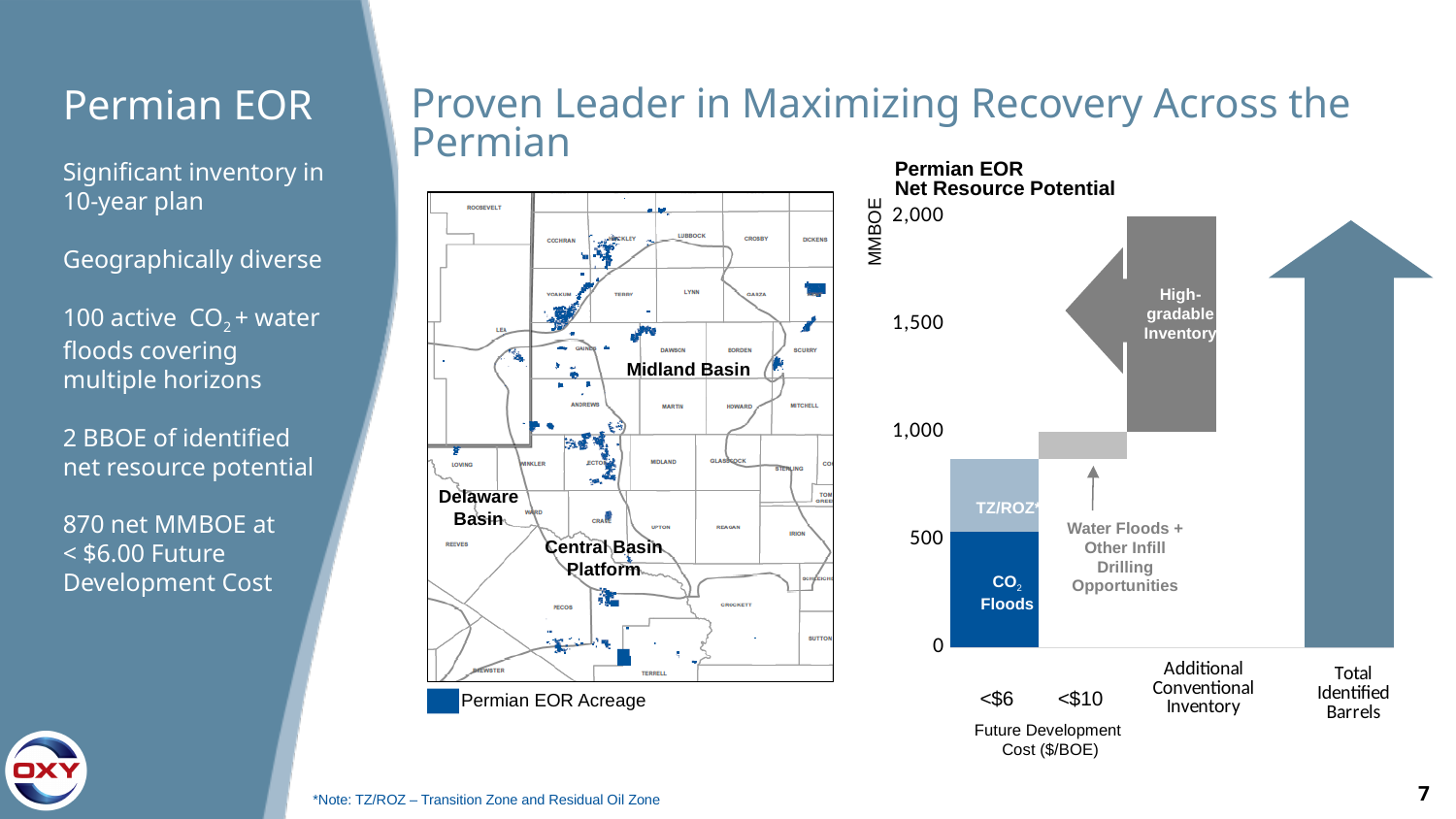
What kind of chart is shown on the slide? Bar chart Is the value for the <$6 bar greater or less than 1,000? less How many categories are shown along the x axis of the chart? 4 Do the bars rise or fall moving from left to right along the x axis? rise Is the value for the <$6 bar greater or less than 500? greater What is the title of the chart on the right side of the slide? Permian EOR Net Resource Potential What unit is shown on the vertical axis of the chart? MMBOE Which is larger, the <$6 bar or the <$10 bar? <$6 Is the value for Total Identified Barrels greater or less than 1,500? greater